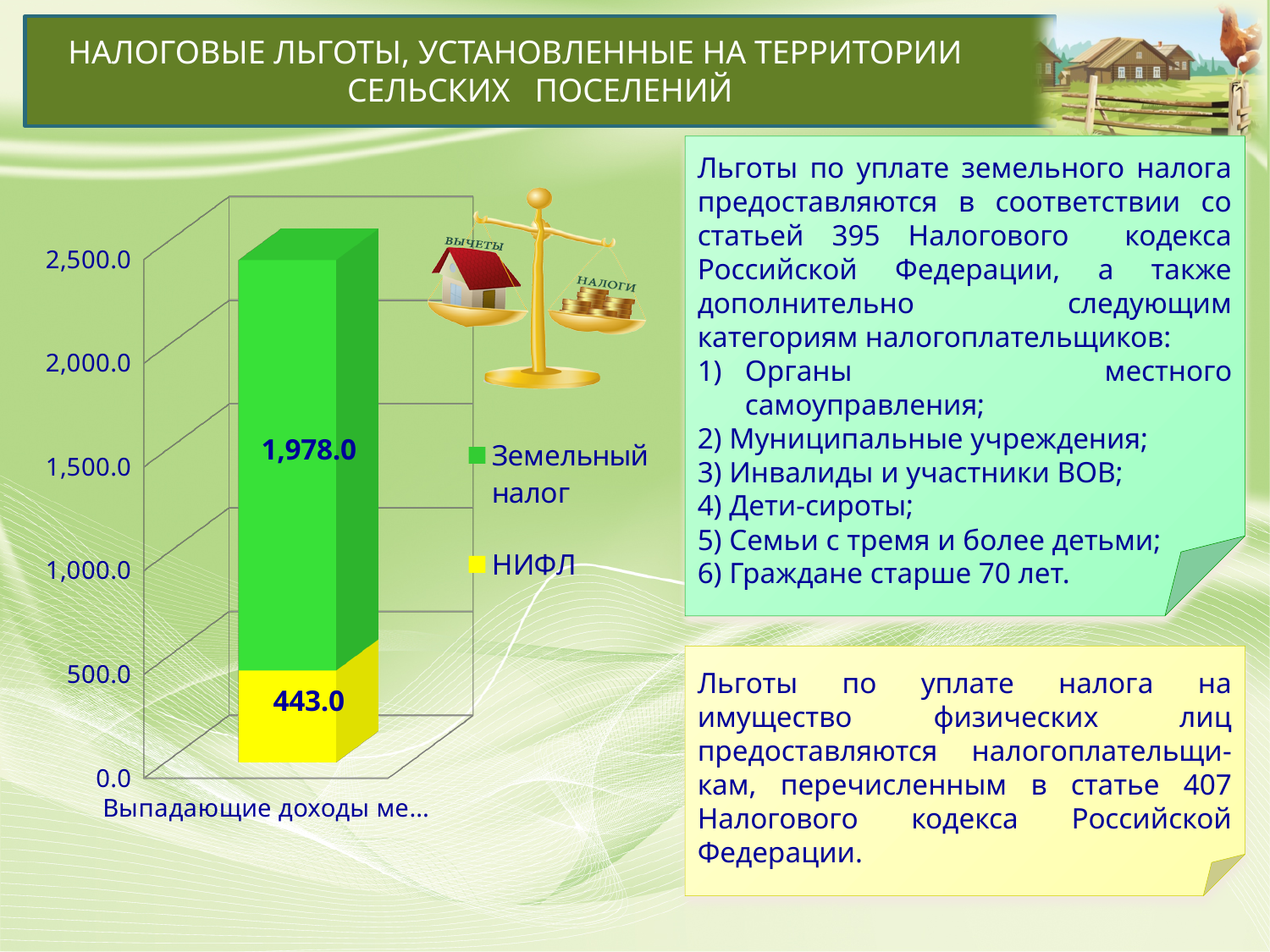
Is the total height of the stacked bar greater or less than 2,000.0? greater Which series has the smallest value in the chart? НИФЛ What is the value of the Земельный налог segment in the stacked bar? 1,978.0 How many series does the legend list? 2 What colour represents the Земельный налог series in the chart? Green What colour represents the НИФЛ series in the chart? Yellow Which series has the largest value in the chart? Земельный налог What is the value of the НИФЛ segment in the stacked bar? 443.0 What kind of chart is shown on the slide? Stacked bar chart Which series has the larger value, Земельный налог or НИФЛ? Земельный налог What is the difference between the Земельный налог value and the НИФЛ value? 1,535.0 What is the total of the stacked bar? 2,421.0